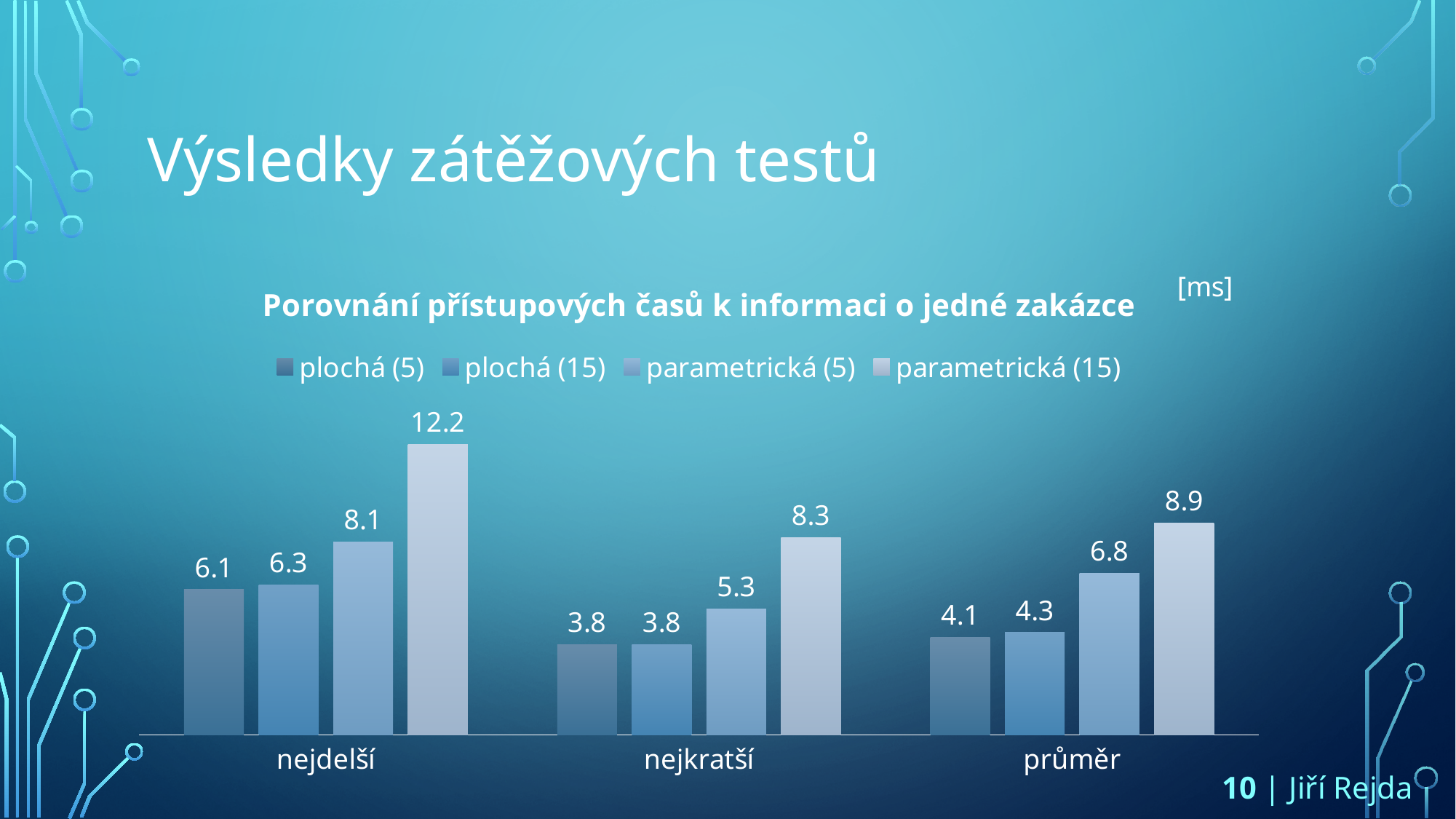
What is the difference between parametrická (15) and parametrická (5) in the nejdelší category? 4.1 What kind of chart is shown on the slide? bar chart How many categories are shown on the x axis? 3 Which category has the lowest value for plochá (15)? nejkratší What is the value for parametrická (15) in the nejdelší category? 12.2 What is the difference between parametrická (15) and plochá (5) in the průměr category? 4.8 Which is larger: parametrická (5) in nejdelší or parametrická (15) in průměr? parametrická (15) in průměr What unit is indicated next to the chart title? [ms] What is the value for plochá (5) in the průměr category? 4.1 What is the value for parametrická (5) in the nejkratší category? 5.3 Which series has the highest value in the nejdelší category? parametrická (15) How many series does the legend list? 4